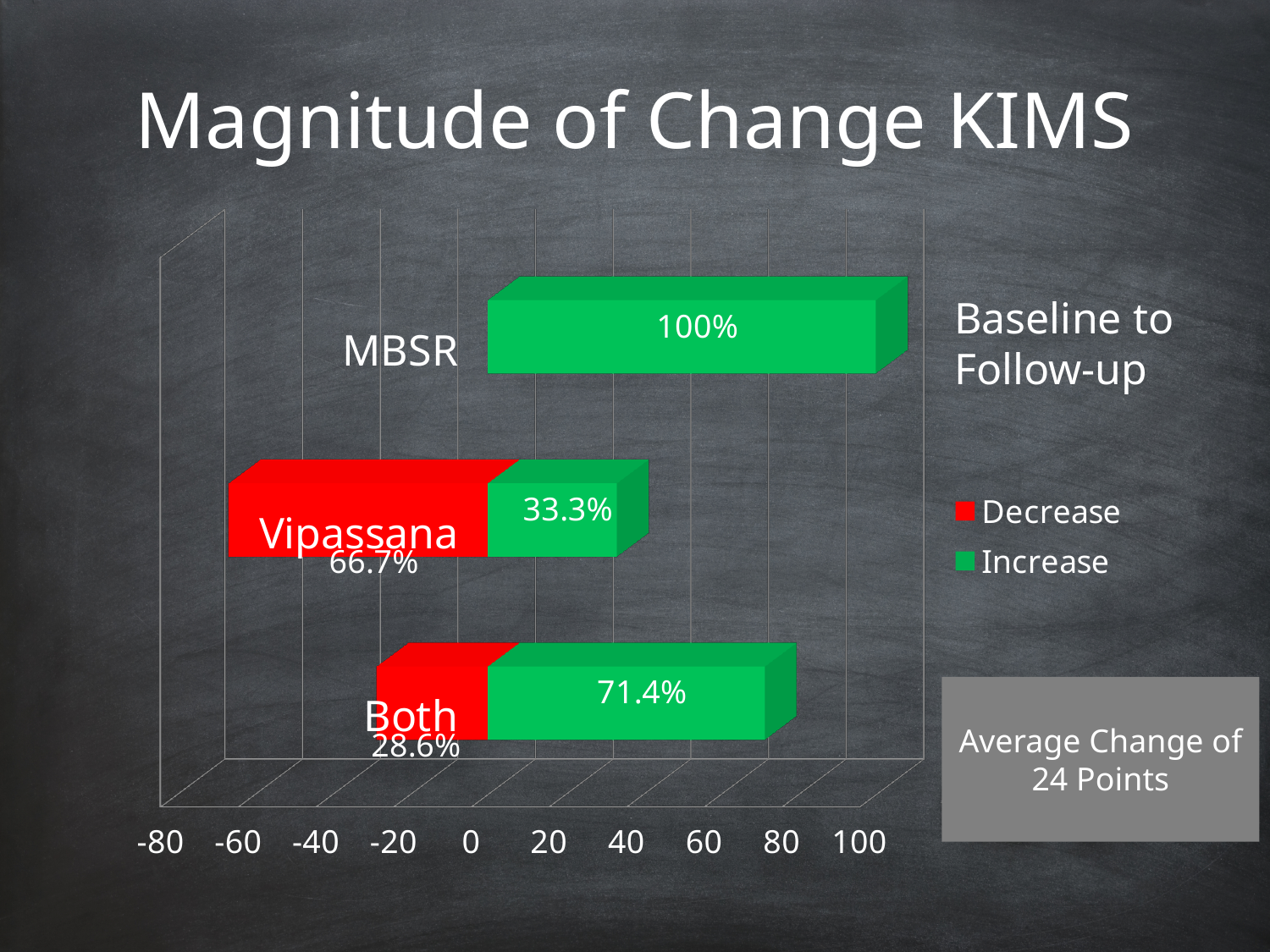
What is the Increase value for MBSR? 100% What is the Increase value for Both? 71.4% Which category has the lowest Increase value? Vipassana Which is larger, the Decrease value for Vipassana or the Decrease value for Both? Vipassana How many series does the legend list? 2 What is the Decrease value for Both? 28.6% What kind of chart is shown on the slide? Bar chart Which category has the highest Increase value? MBSR What is the difference between the Increase values for Both and Vipassana? 38.1% How many categories are shown on the chart? 3 Which colour represents the Decrease series in the legend? Red What is the Decrease value for Vipassana? 66.7%